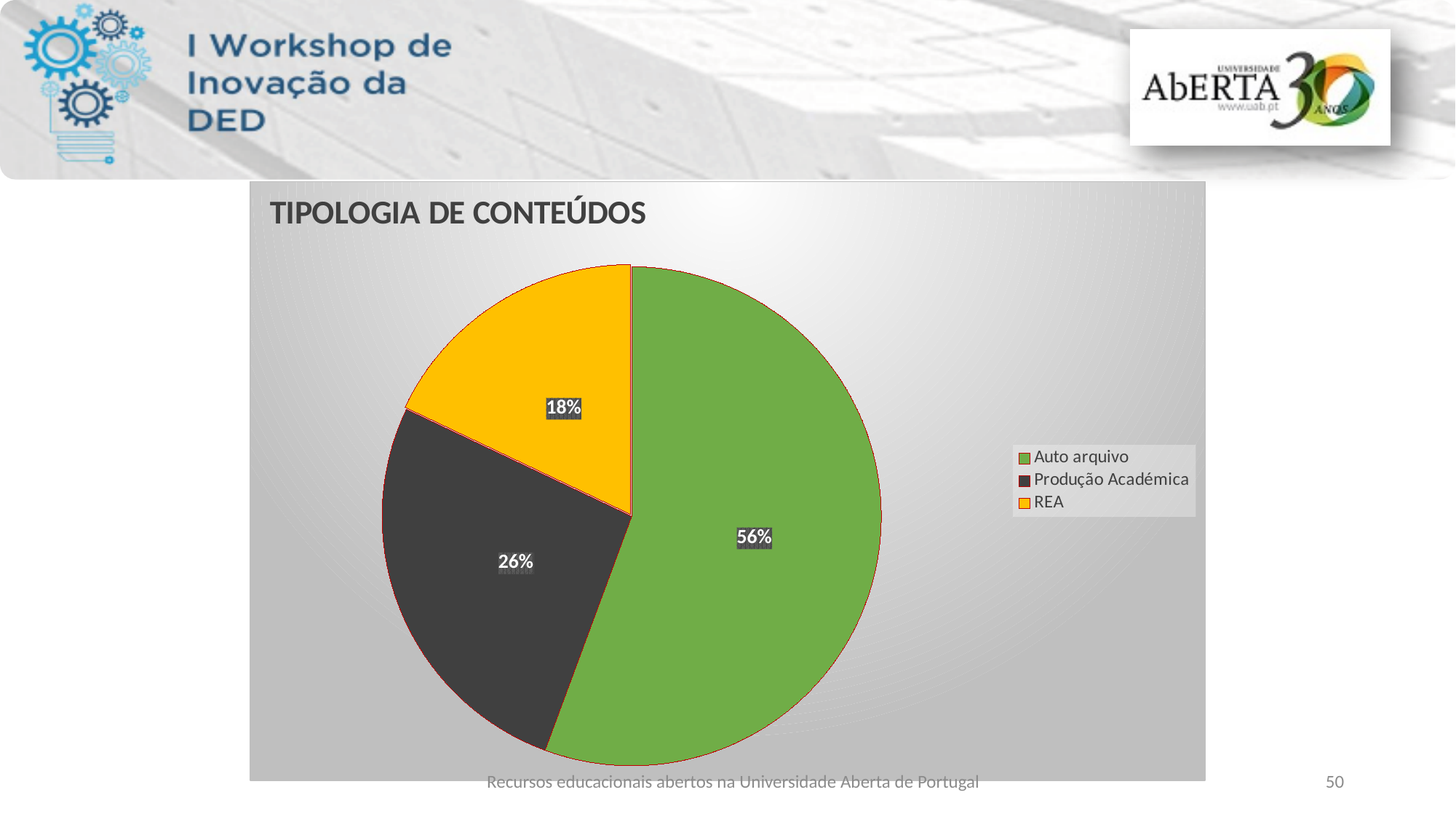
Which is larger, the share for Produção Académica or the share for REA? Produção Académica Which category has the smallest slice of the pie? REA What colour is the slice for REA? Yellow Which category has the largest slice of the pie? Auto arquivo What is the difference in percentage points between Auto arquivo and Produção Académica? 30 What share of the pie does Auto arquivo represent? 56% What type of chart is shown on the slide? Pie chart What is the title of the chart? TIPOLOGIA DE CONTEÚDOS What share of the pie does REA represent? 18% How many categories does the legend list? 3 What is the difference in percentage points between Produção Académica and REA? 8 What share of the pie does Produção Académica represent? 26%